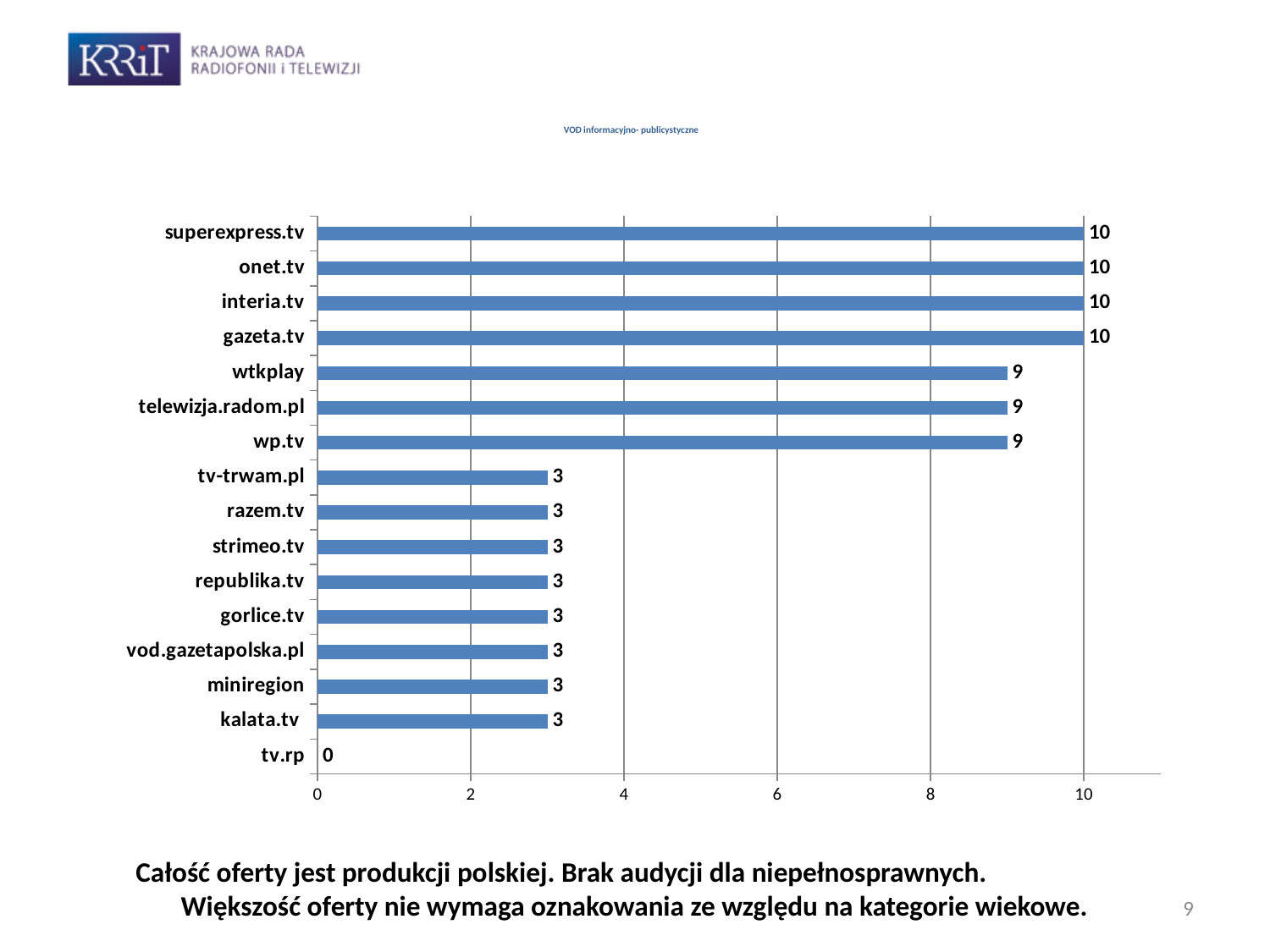
Is the value for wp.tv greater or less than 8? greater What is the value for gazeta.tv? 10 What is the difference between the values for telewizja.radom.pl and kalata.tv? 6 What is the value for tv.rp? 0 Which is larger, the value for interia.tv or the value for razem.tv? interia.tv What kind of chart is shown on the slide? bar chart What is the value for tv-trwam.pl? 3 What is the value for wtkplay? 9 Which category has the lowest value? tv.rp How many categories are shown in the chart? 16 What is the title of the chart? VOD informacyjno- publicystyczne What is the difference between the values for onet.tv and wp.tv? 1